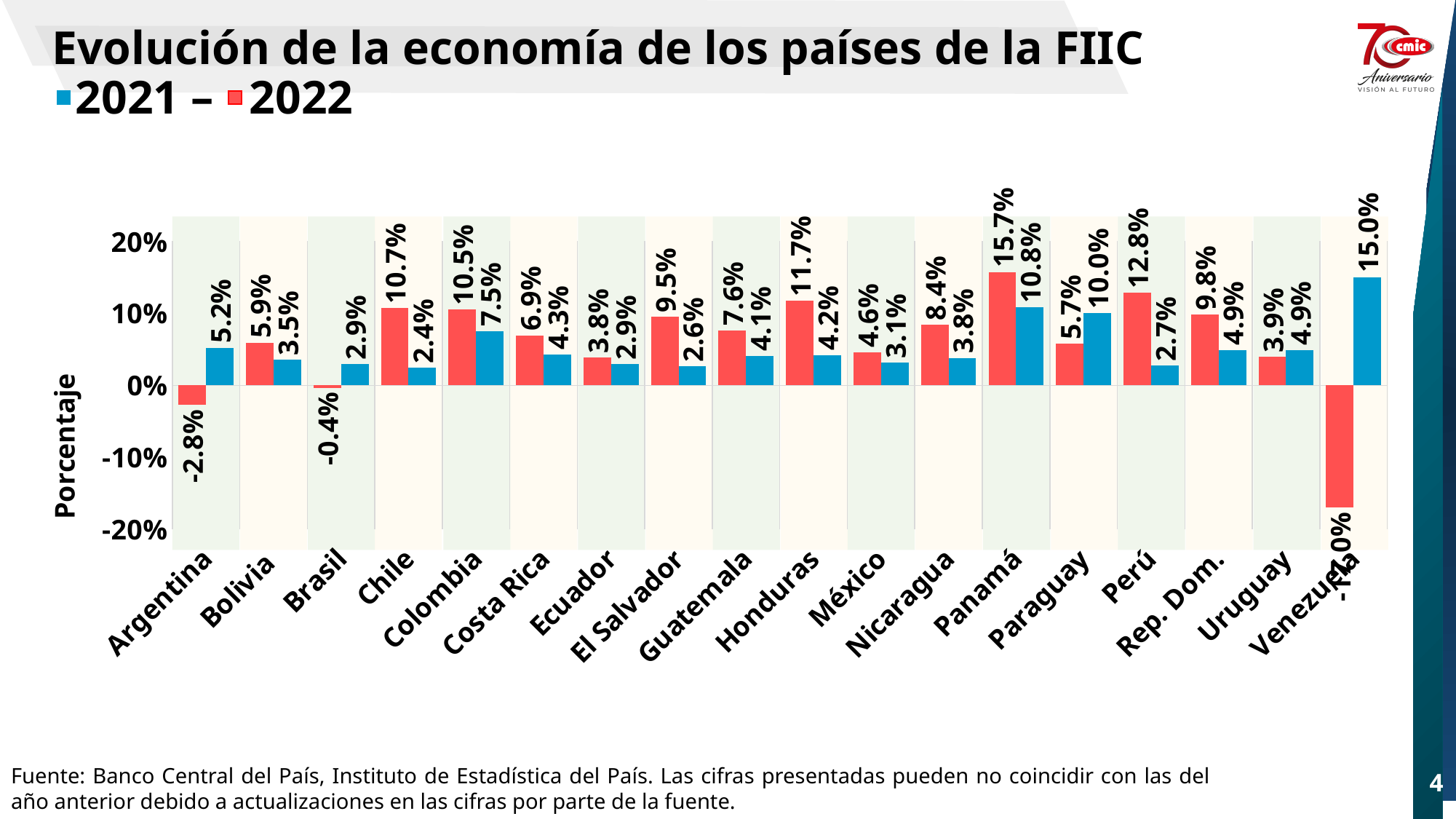
How many countries are shown on the x axis? 18 What kind of chart is shown on the slide? bar chart Which country has the highest 2022 (red) value? Panamá What is the difference between the 2022 (red) and 2021 (blue) values for Chile? 8.3 percentage points Which country has the lowest 2021 (blue) value? Chile What is the 2022 (red) value for Argentina? -2.8% What is the 2022 (red) value for Panamá? 15.7% What is the 2021 (blue) value for Colombia? 7.5% How many series does the legend list? 2 Is the 2022 (red) value for Venezuela greater or less than -10%? less Which country has the highest 2021 (blue) value? Venezuela For Paraguay, which is larger: the 2021 (blue) value or the 2022 (red) value? 2021 (blue)